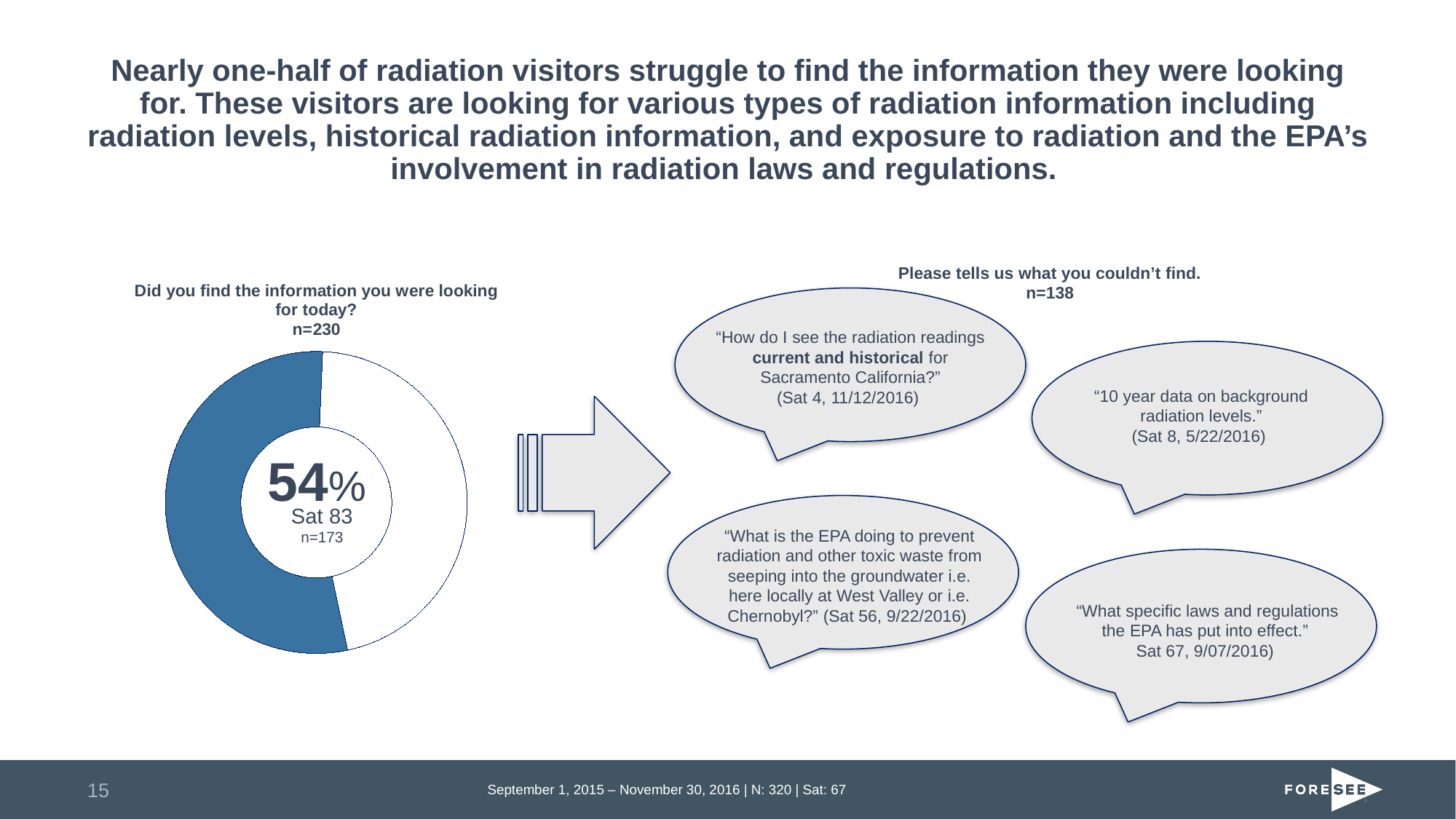
What question is the donut chart titled with? Did you find the information you were looking for today? What percentage is printed in the centre of the donut chart? 54% What sample size (n) is given in the title of the donut chart? n=230 How many segments does the donut chart have? 2 Is the share of the blue segment in the donut chart greater or less than 50%? greater What sample size (n) is printed in the centre of the donut chart? n=173 What satisfaction score is printed in the centre of the donut chart? Sat 83 What kind of chart is shown on the left of the slide? Donut chart What share of the donut chart does the blue segment represent? 54% Which segment of the donut chart is larger, the blue one or the white one? The blue one